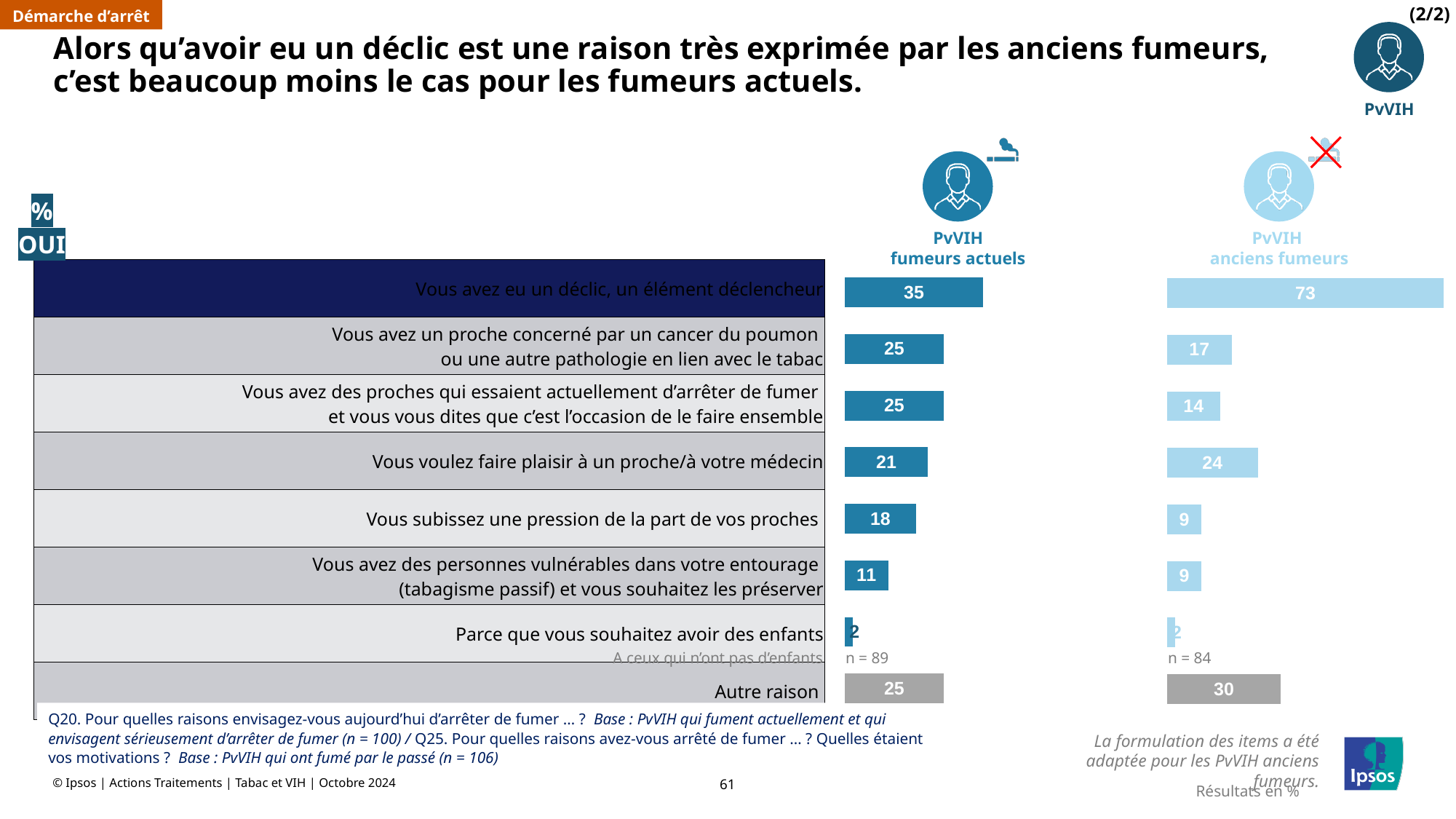
In the 'PvVIH anciens fumeurs' chart, what is the value for 'Vous avez eu un déclic, un élément déclencheur'? 73 In the 'PvVIH anciens fumeurs' chart, which reason has the lowest value? Parce que vous souhaitez avoir des enfants How many reasons (categories) are listed in the charts? 8 For 'Vous voulez faire plaisir à un proche/à votre médecin', which group has the larger value: 'PvVIH fumeurs actuels' or 'PvVIH anciens fumeurs'? PvVIH anciens fumeurs For 'Vous avez un proche concerné par un cancer du poumon ou une autre pathologie en lien avec le tabac', which group has the larger value: 'PvVIH fumeurs actuels' or 'PvVIH anciens fumeurs'? PvVIH fumeurs actuels In the 'PvVIH anciens fumeurs' chart, what is the value for 'Autre raison'? 30 In the 'PvVIH fumeurs actuels' chart, what is the value for 'Vous subissez une pression de la part de vos proches'? 18 In the 'PvVIH fumeurs actuels' chart, which reason has the highest value? Vous avez eu un déclic, un élément déclencheur In the 'PvVIH fumeurs actuels' chart, what is the value for 'Vous avez eu un déclic, un élément déclencheur'? 35 In the 'PvVIH anciens fumeurs' chart, what is the value for 'Vous voulez faire plaisir à un proche/à votre médecin'? 24 What is the difference between the 'PvVIH anciens fumeurs' and 'PvVIH fumeurs actuels' values for 'Vous avez eu un déclic, un élément déclencheur'? 38 What kind of chart is used on this slide? Bar chart